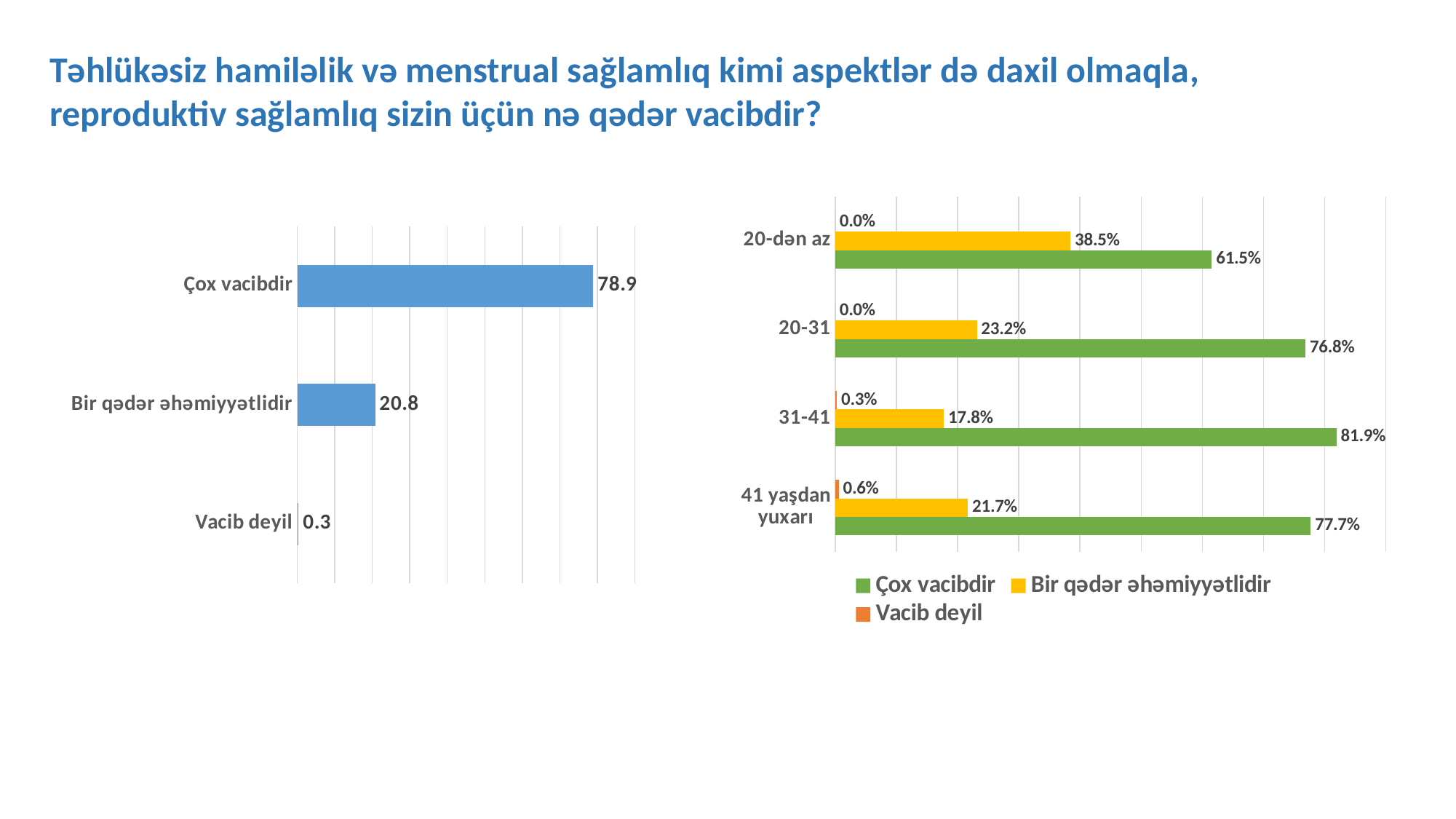
In the right chart, what is the Bir qədər əhəmiyyətlidir value for the 20-dən az age group? 38.5% In the right chart, how many series does the legend list? 3 In the left chart, what is the value for Çox vacibdir? 78.9 In the right chart, which age group has the lowest Çox vacibdir value? 20-dən az In the right chart, what is the difference between the Çox vacibdir values for 20-31 and 20-dən az? 15.3% What kind of chart is the left chart? Bar chart In the left chart, which category has the lowest value? Vacib deyil In the left chart, how many categories are shown? 3 In the left chart, what is the difference between Çox vacibdir and Bir qədər əhəmiyyətlidir? 58.1 In the right chart, what is the Çox vacibdir value for the 31-41 age group? 81.9% In the left chart, what is the value for Bir qədər əhəmiyyətlidir? 20.8 In the right chart, which age group has the highest Çox vacibdir value? 31-41